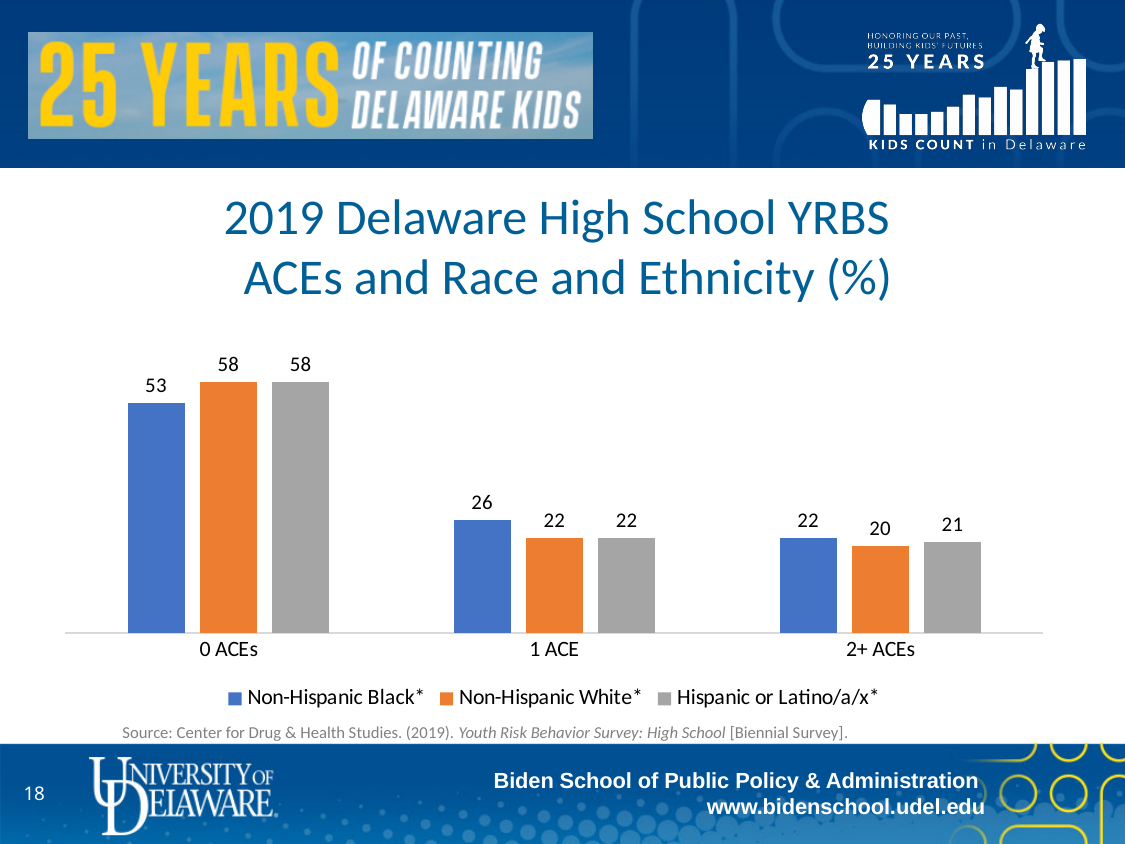
What is the value for Non-Hispanic White* students with 2+ ACEs? 20 What is the value for Non-Hispanic Black* students with 0 ACEs? 53 Which colour represents Hispanic or Latino/a/x* in the legend? Gray How many series does the legend list? 3 Which series has the lowest value in the 0 ACEs category? Non-Hispanic Black* How many categories are shown on the x axis? 3 What is the difference between the Non-Hispanic White* and Non-Hispanic Black* values for 0 ACEs? 5 What kind of chart is shown on the slide? Bar chart Which is larger for 2+ ACEs: the Non-Hispanic Black* value or the Non-Hispanic White* value? Non-Hispanic Black* Which series has the highest value in the 1 ACE category? Non-Hispanic Black* Do the Non-Hispanic White* values rise or fall from 0 ACEs to 2+ ACEs? Fall What is the value for Hispanic or Latino/a/x* students with 1 ACE? 22